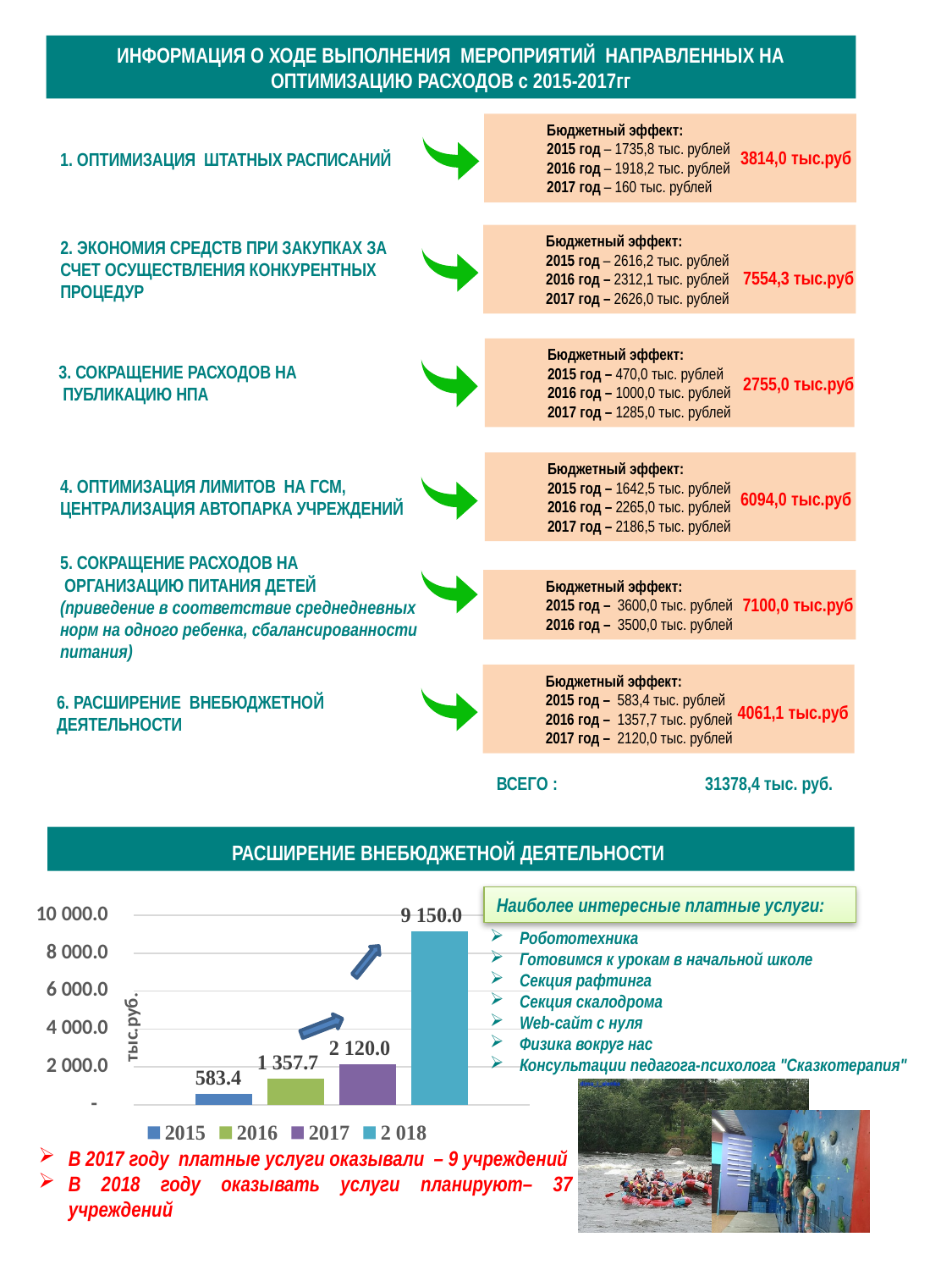
Do the values in the bar chart rise or fall from 2015 to 2018? rise In the bar chart, what is the value for 2015? 583.4 In the bar chart, which is larger: the value for 2016 or the value for 2017? 2017 In the bar chart, what is the value for 2016? 1 357.7 How many bars are plotted in the bar chart? 4 In the bar chart, which year has the lowest value? 2015 What type of chart is shown under the heading "РАСШИРЕНИЕ ВНЕБЮДЖЕТНОЙ ДЕЯТЕЛЬНОСТИ"? bar chart In the bar chart, what is the difference between the values for 2018 and 2017? 7 030.0 How many entries does the legend of the bar chart list? 4 In the bar chart, what is the value for 2017? 2 120.0 In the bar chart, what is the value for 2018? 9 150.0 In the bar chart, which year has the highest value? 2018